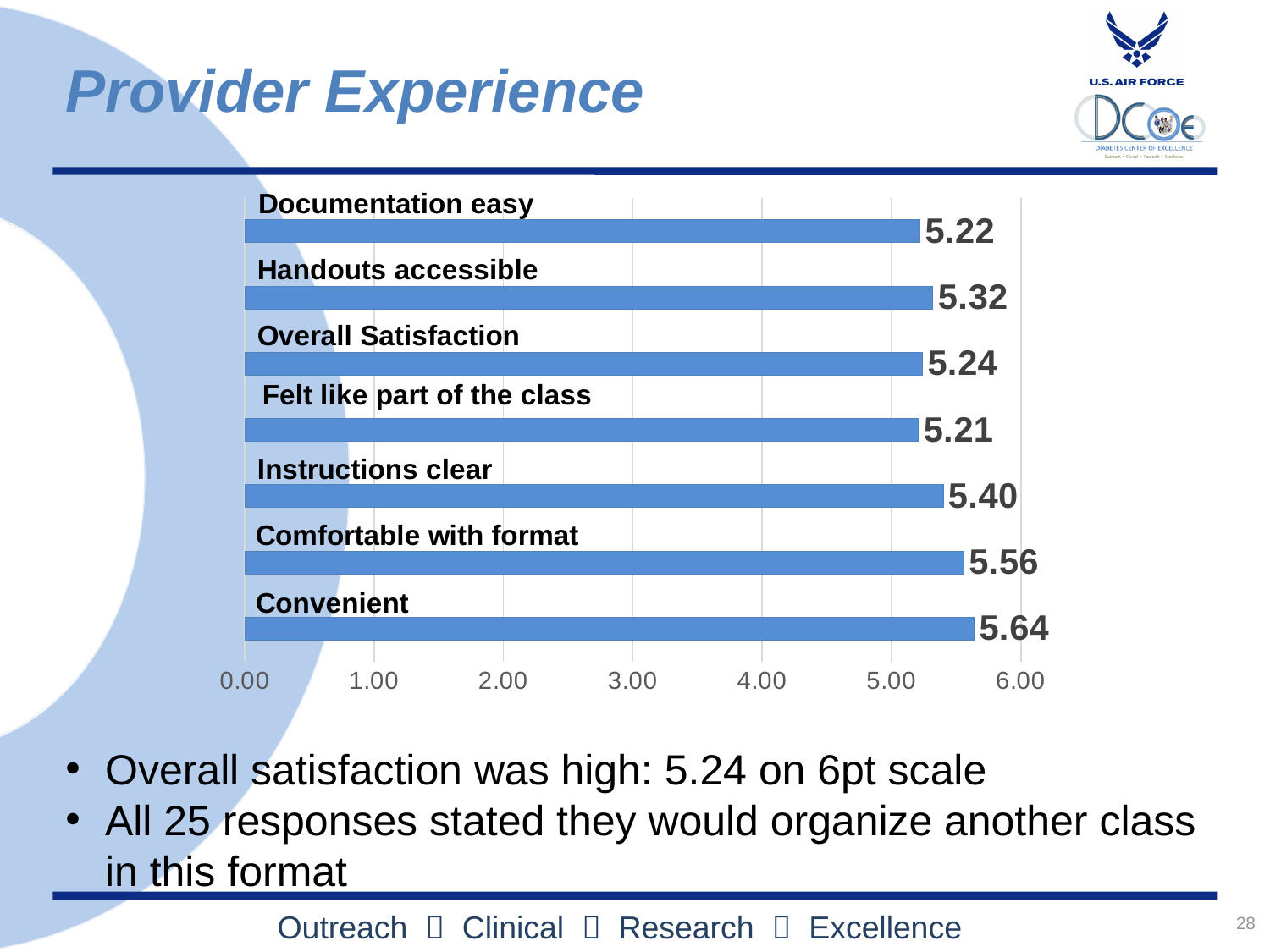
Which is larger, the value for Handouts accessible or the value for Overall Satisfaction? Handouts accessible What is the value for Convenient? 5.64 How many categories are shown in the chart? 7 Is the value for Comfortable with format greater or less than 5.00? greater What is the difference between the values for Convenient and Documentation easy? 0.42 What is the value for Documentation easy? 5.22 What is the maximum value shown on the x axis? 6.00 What kind of chart is shown on the slide? bar chart What is the difference between the values for Comfortable with format and Instructions clear? 0.16 What is the value for Instructions clear? 5.40 Which category has the lowest value? Felt like part of the class Which category has the highest value? Convenient